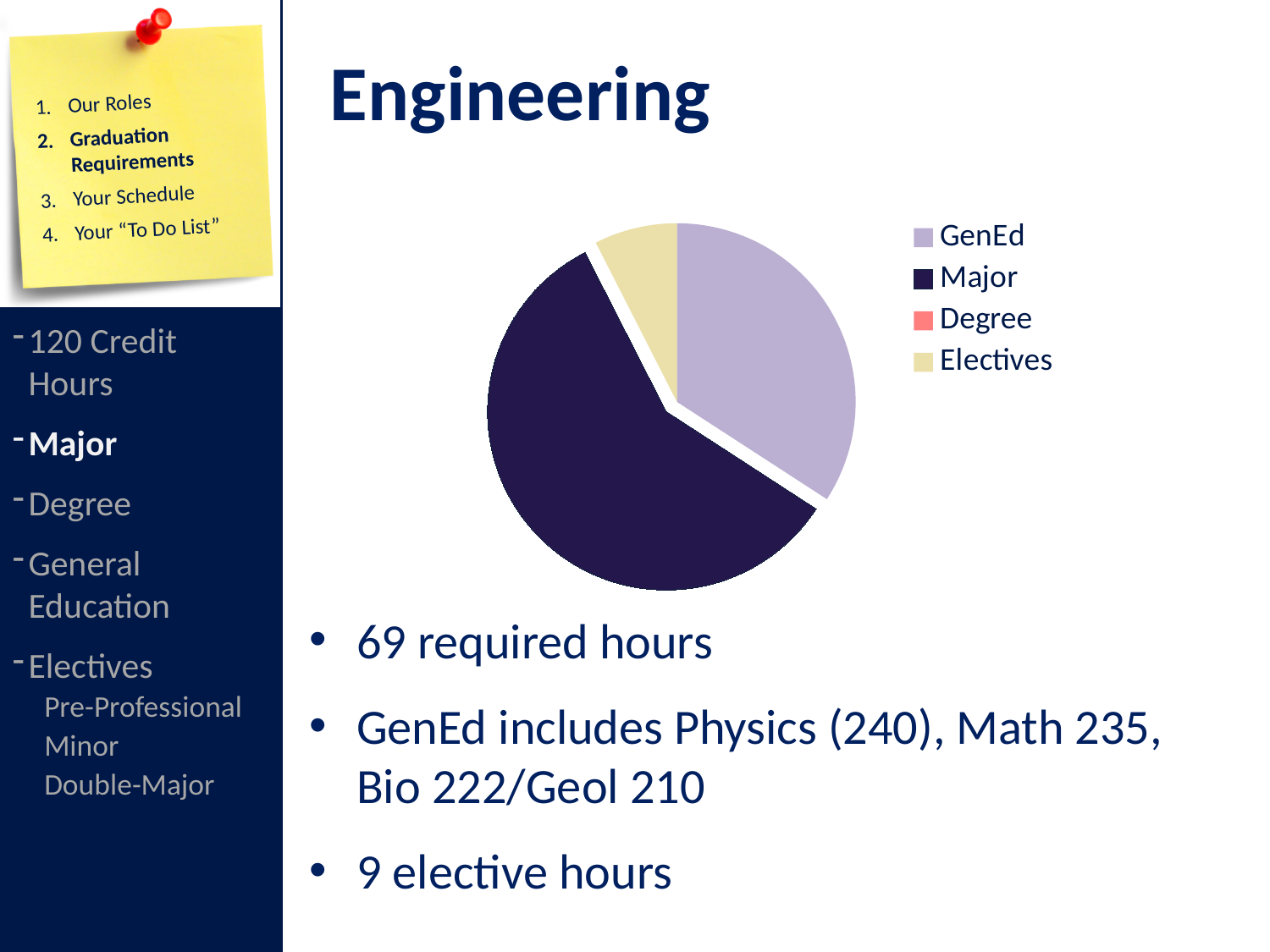
How many categories does the pie chart's legend list? 4 Which category has the largest slice of the pie chart? Major What kind of chart is shown on the slide? pie chart Which legend entry is shown in the darkest colour in the pie chart? Major Which slice is larger in the pie chart, GenEd or Major? Major Which slice is larger in the pie chart, GenEd or Electives? GenEd What are the legend entries of the pie chart, in order? GenEd, Major, Degree, Electives Does the Major slice take up more or less than half of the pie chart? more Which slice is smaller in the pie chart, Electives or Major? Electives Does the Electives slice take up more or less than a quarter of the pie chart? less